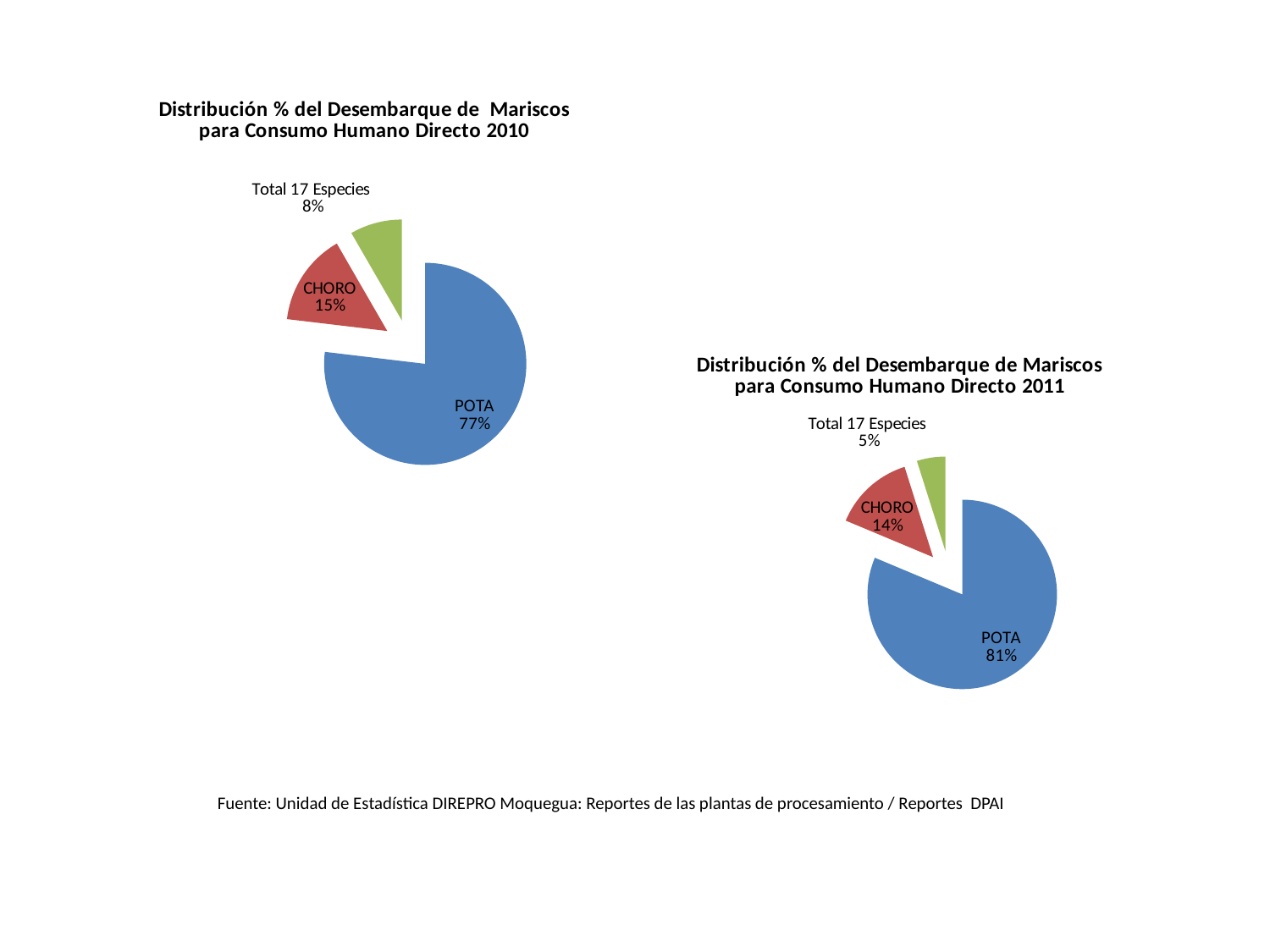
In the 2011 chart, which category has the smallest slice? Total 17 Especies In the 2010 chart, what share does 'Total 17 Especies' have? 8% In the 2010 chart, which category has the largest slice? POTA In the 2011 chart, what share does CHORO have? 14% Is the CHORO share larger in the 2010 chart or the 2011 chart? 2010 In the 2010 chart (Distribución % del Desembarque de Mariscos para Consumo Humano Directo 2010), what share does POTA have? 77% What type of chart is used on the left side of the slide? Pie chart What is the difference between the POTA share in the 2011 chart and the POTA share in the 2010 chart? 4% In the 2011 chart (Distribución % del Desembarque de Mariscos para Consumo Humano Directo 2011), what share does POTA have? 81% In the 2011 chart, what share does 'Total 17 Especies' have? 5% How many slices does the 2011 chart have? 3 In the 2010 chart, what share does CHORO have? 15%